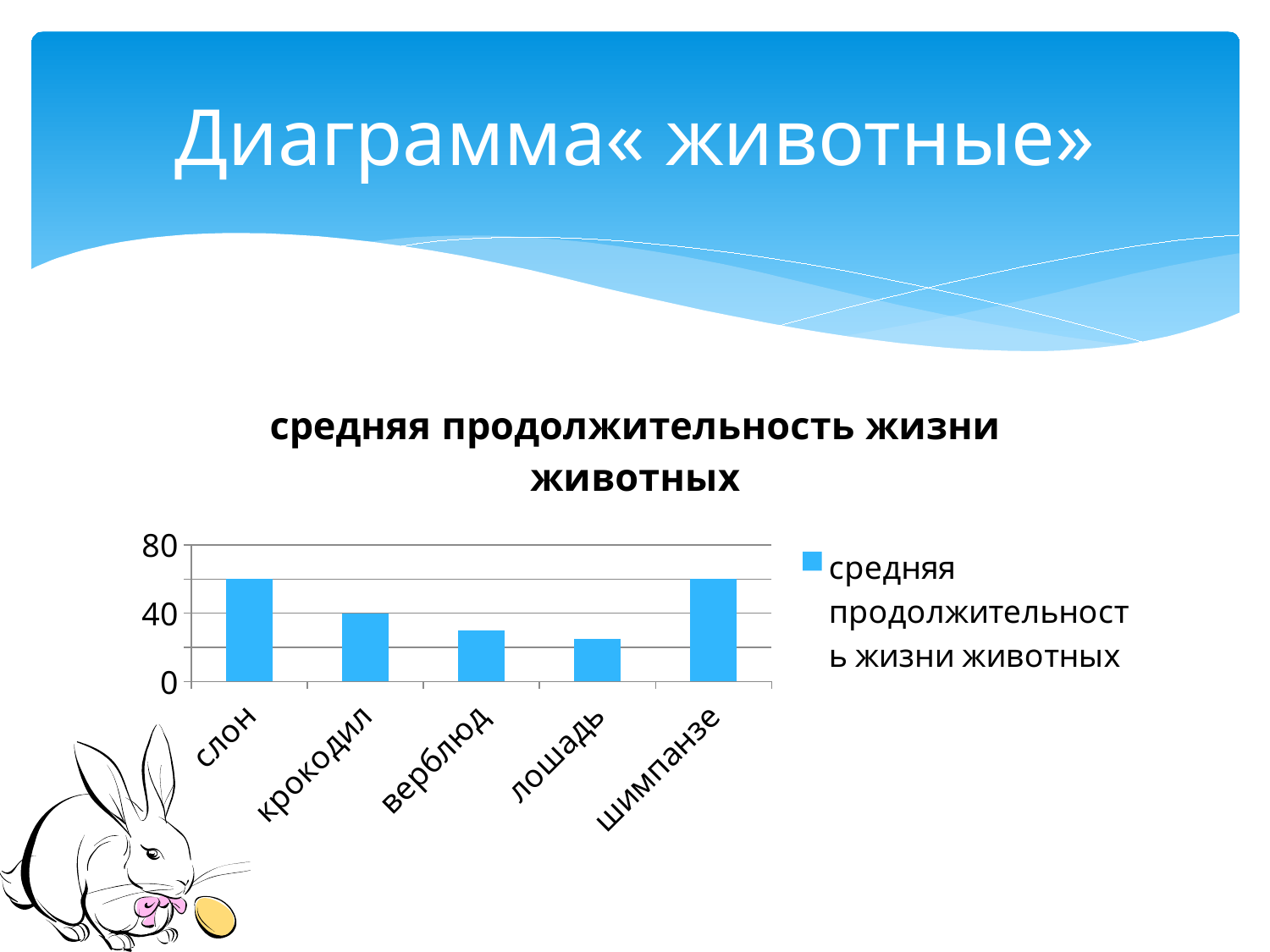
Is the value for шимпанзе greater or less than 40? greater Which has the larger value, слон or крокодил? слон What is the name of the series listed in the chart legend? средняя продолжительность жизни животных What kind of chart is shown on the slide? bar chart Is the value for верблюд greater or less than 40? less Is the value for лошадь greater or less than 40? less Which animal has the lowest value in the chart? лошадь Which has the larger value, верблюд or лошадь? верблюд How many animal categories are shown on the x axis of the chart? 5 How many series does the chart legend list? 1 What is the title of the chart? средняя продолжительность жизни животных